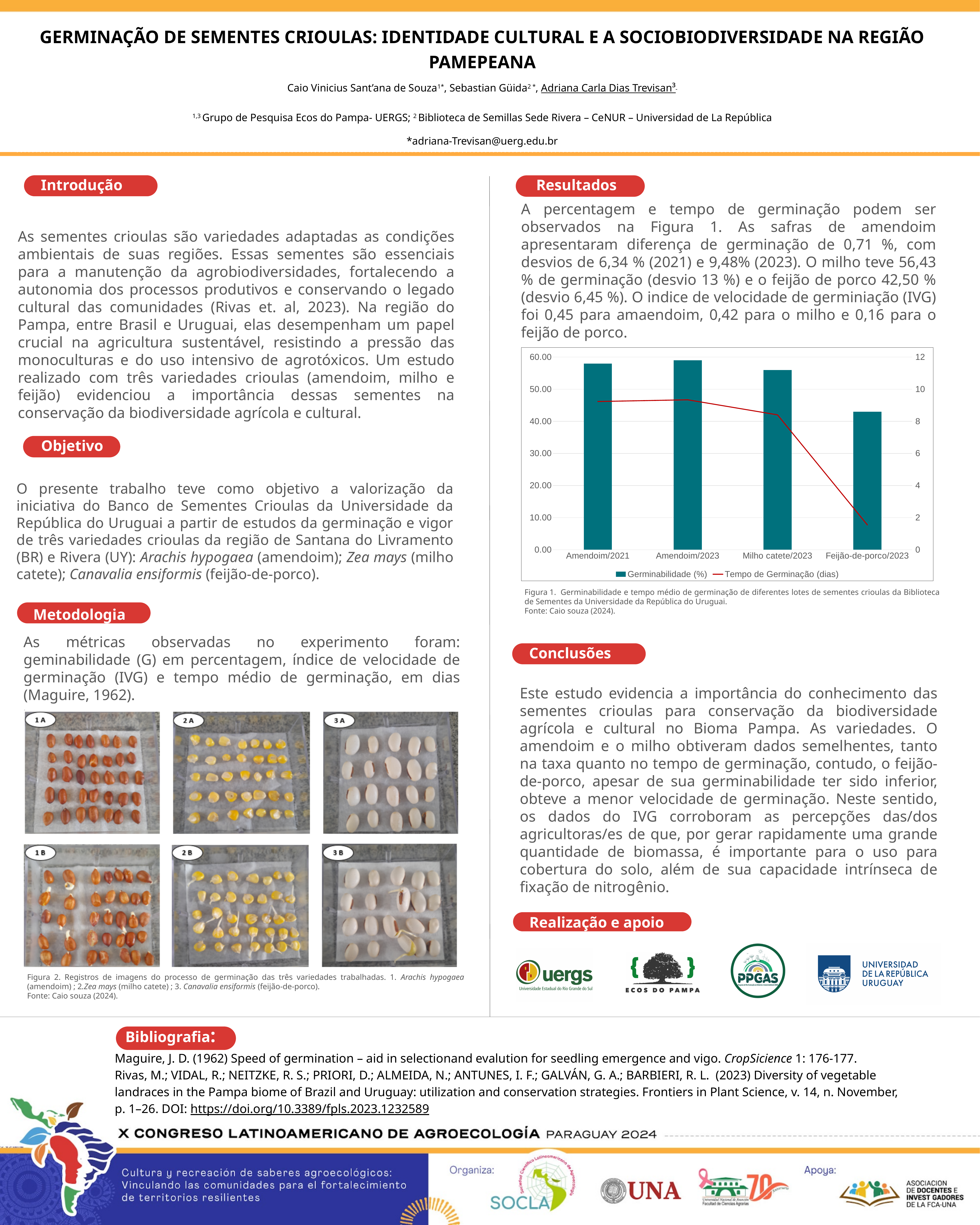
Is the Germinabilidade (%) value for Feijão-de-porco/2023 greater or less than 50.00? less Which category has the lowest Tempo de Germinação (dias) value on the line? Feijão-de-porco/2023 How many categories are shown on the x axis of the chart in Figura 1? 4 Does the Tempo de Germinação (dias) line rise or fall overall from Amendoim/2021 to Feijão-de-porco/2023? fall How many series does the legend of the chart in Figura 1 list? 2 What are the two legend entries of the chart in Figura 1? Germinabilidade (%) and Tempo de Germinação (dias) What kind of chart is shown in Figura 1? A bar chart with a line series Which has the larger Germinabilidade (%) bar, Milho catete/2023 or Feijão-de-porco/2023? Milho catete/2023 Which category has the lowest Germinabilidade (%) bar in the chart? Feijão-de-porco/2023 Is the Germinabilidade (%) value for Amendoim/2021 greater or less than 50.00? greater Is the Germinabilidade (%) value for Milho catete/2023 greater or less than 50.00? greater